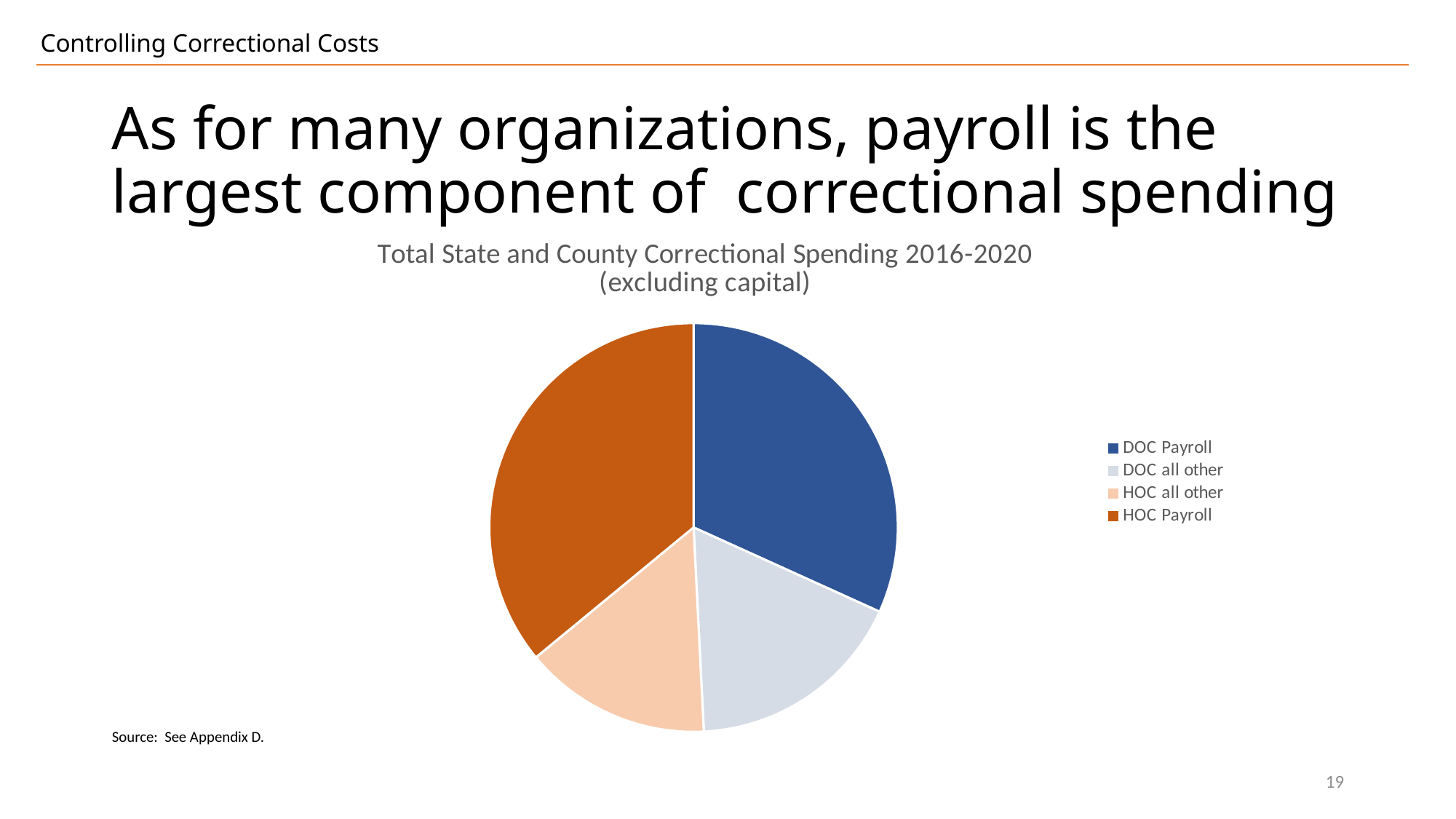
What kind of chart is shown on the slide? pie chart Which slice is larger, HOC Payroll or HOC all other? HOC Payroll Which slice is larger, DOC Payroll or HOC all other? DOC Payroll How many entries does the legend of the pie chart list? 4 How many slices does the pie chart have? 4 Which legend entry is listed first in the pie chart's legend? DOC Payroll What is the title of the pie chart? Total State and County Correctional Spending 2016-2020 (excluding capital) Which slice is larger, HOC Payroll or DOC all other? HOC Payroll Which colour represents HOC Payroll in the pie chart? orange